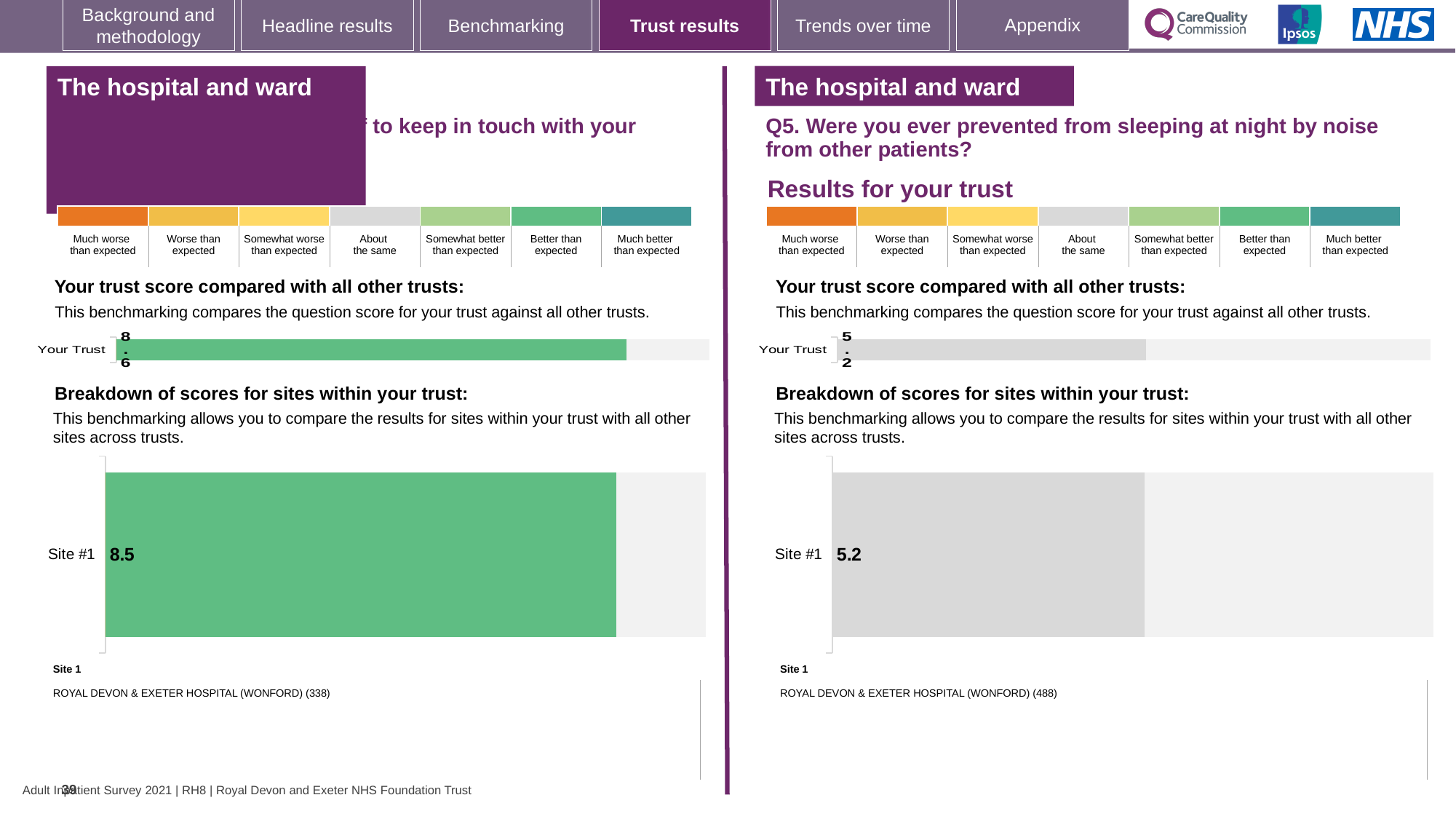
On the left-hand chart, what is the score shown for Your Trust? 8.6 On the right-hand Q5 chart, what colour is the Site #1 bar? Grey On the left-hand chart, which is larger: the Your Trust score or the Site #1 score? Your Trust On the right-hand chart for Q5, what is the score shown for Site #1? 5.2 On the left-hand chart, what is the difference between the Your Trust score and the Site #1 score? 0.1 How many sites are shown in the breakdown of scores on the right-hand Q5 chart? 1 On the right-hand chart for Q5 (prevented from sleeping at night by noise from other patients), what is the score shown for Your Trust? 5.2 On the left-hand chart, what is the score shown for Site #1? 8.5 What kind of chart is used to show the Site #1 score on the right-hand Q5 chart? Bar chart Which is larger: the Site #1 score on the left-hand chart or the Site #1 score on the right-hand Q5 chart? Left-hand chart (8.5) On the left-hand chart, what colour is the Site #1 bar? Green Which site name is listed as Site 1 on the right-hand Q5 chart? ROYAL DEVON & EXETER HOSPITAL (WONFORD) (488)